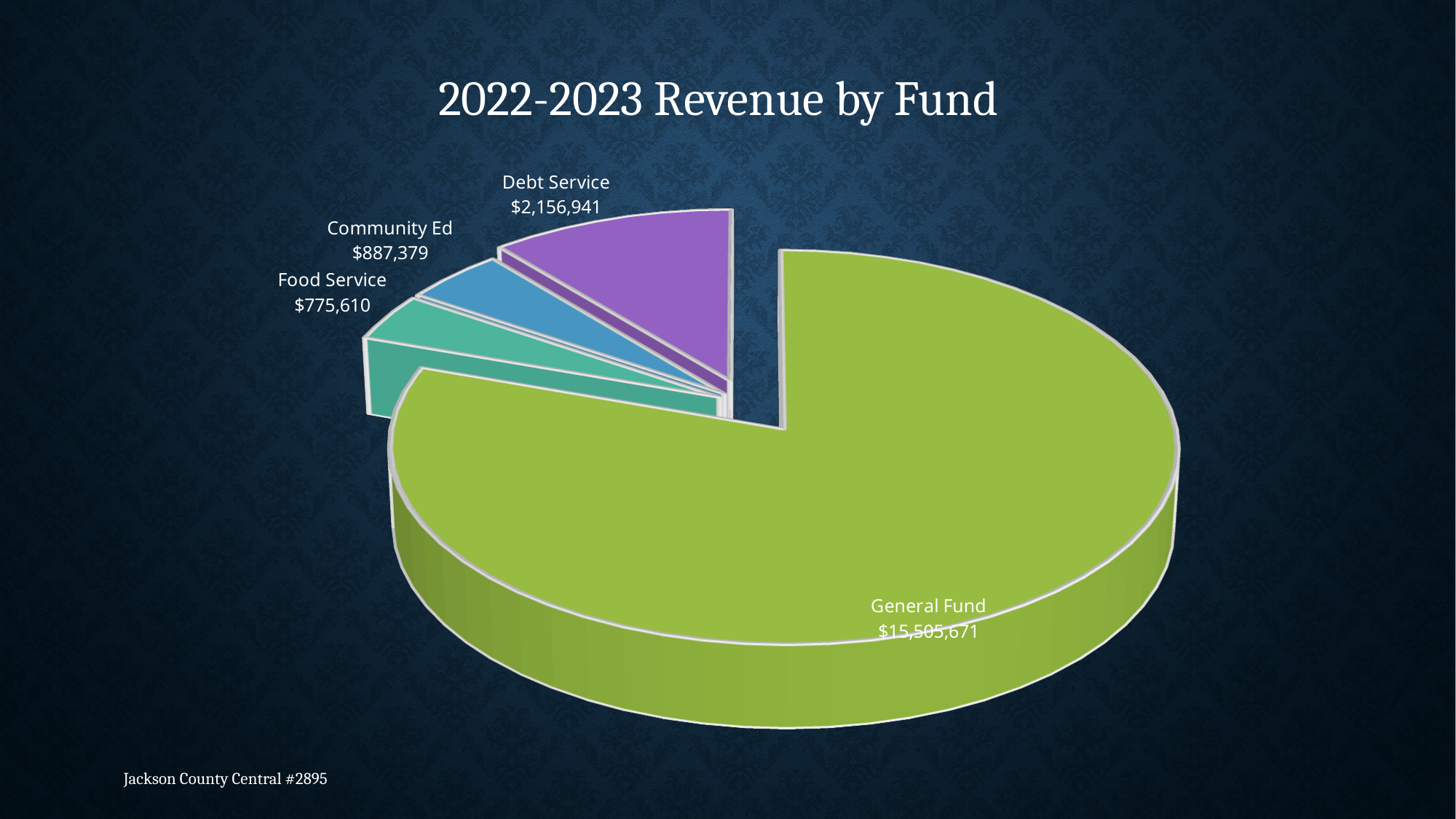
What is the difference between Community Ed and Food Service revenue? $111,769 How many funds are shown in the pie chart? 4 What is the title of the chart? 2022-2023 Revenue by Fund What is the value for Debt Service? $2,156,941 Which fund has the highest revenue? General Fund What is the value for the General Fund slice? $15,505,671 Which is larger, Debt Service or Community Ed? Debt Service What is the value for Food Service? $775,610 What kind of chart is shown on the slide? Pie chart What is the value for Community Ed? $887,379 What is the difference between Debt Service and Community Ed revenue? $1,269,562 Which fund has the lowest revenue? Food Service